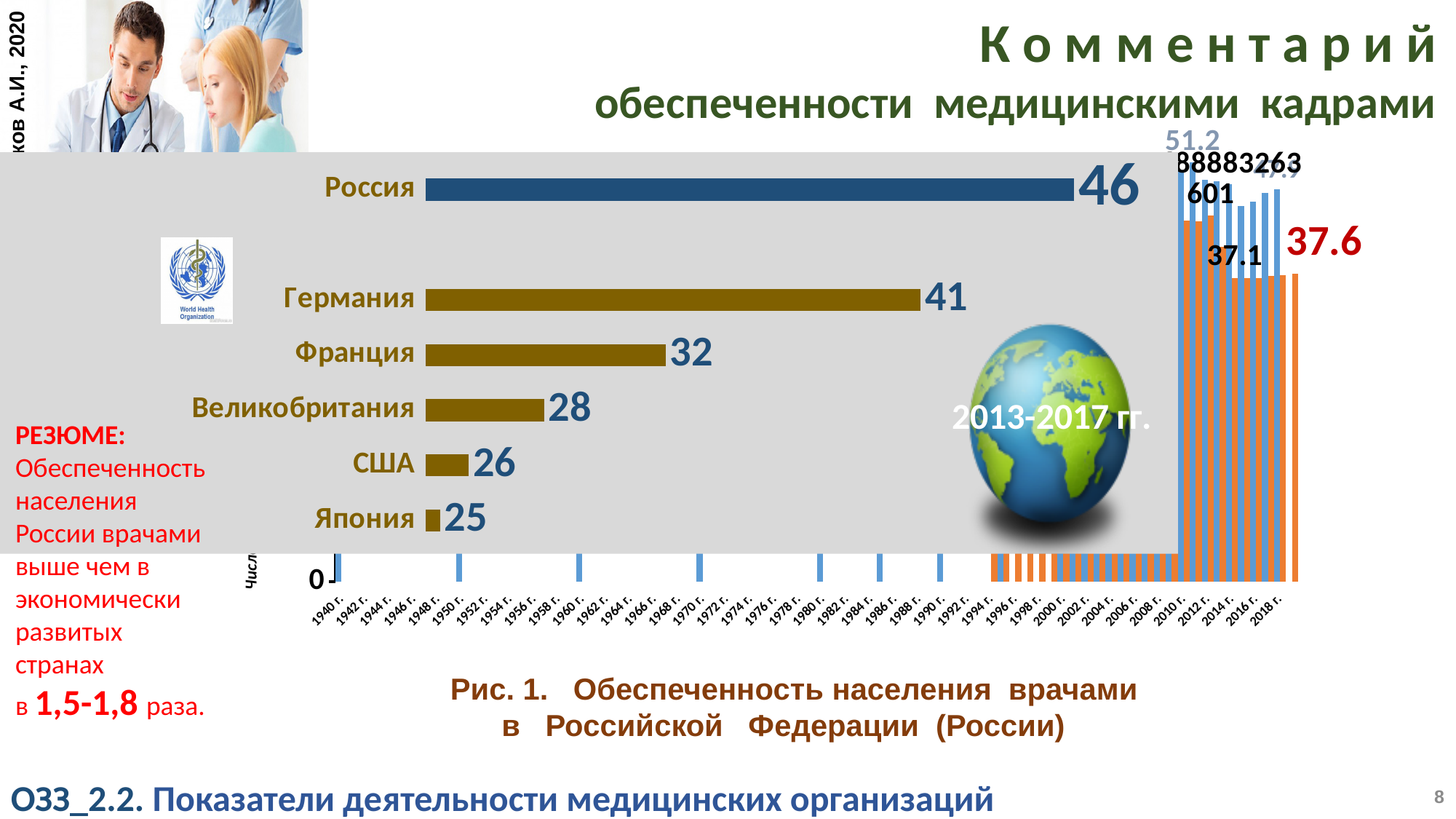
In the horizontal bar chart comparing countries, what is the difference between the values for Россия and Германия? 5 In the horizontal bar chart comparing countries, which has a larger value, Великобритания or США? Великобритания In the horizontal bar chart comparing countries, what is the value for Германия? 41 In the horizontal bar chart comparing countries, what is the value for Россия? 46 In the horizontal bar chart comparing countries, what is the difference between the values for Франция and США? 6 In the horizontal bar chart comparing countries, what is the value for Франция? 32 In the horizontal bar chart comparing countries, which country has the highest value? Россия What type of chart is the chart comparing countries? Bar chart In the horizontal bar chart comparing countries, what is the value for Великобритания? 28 How many countries are shown in the horizontal bar chart comparing countries? 6 In the horizontal bar chart comparing countries, what is the value for Япония? 25 In the horizontal bar chart comparing countries, which country has the lowest value? Япония